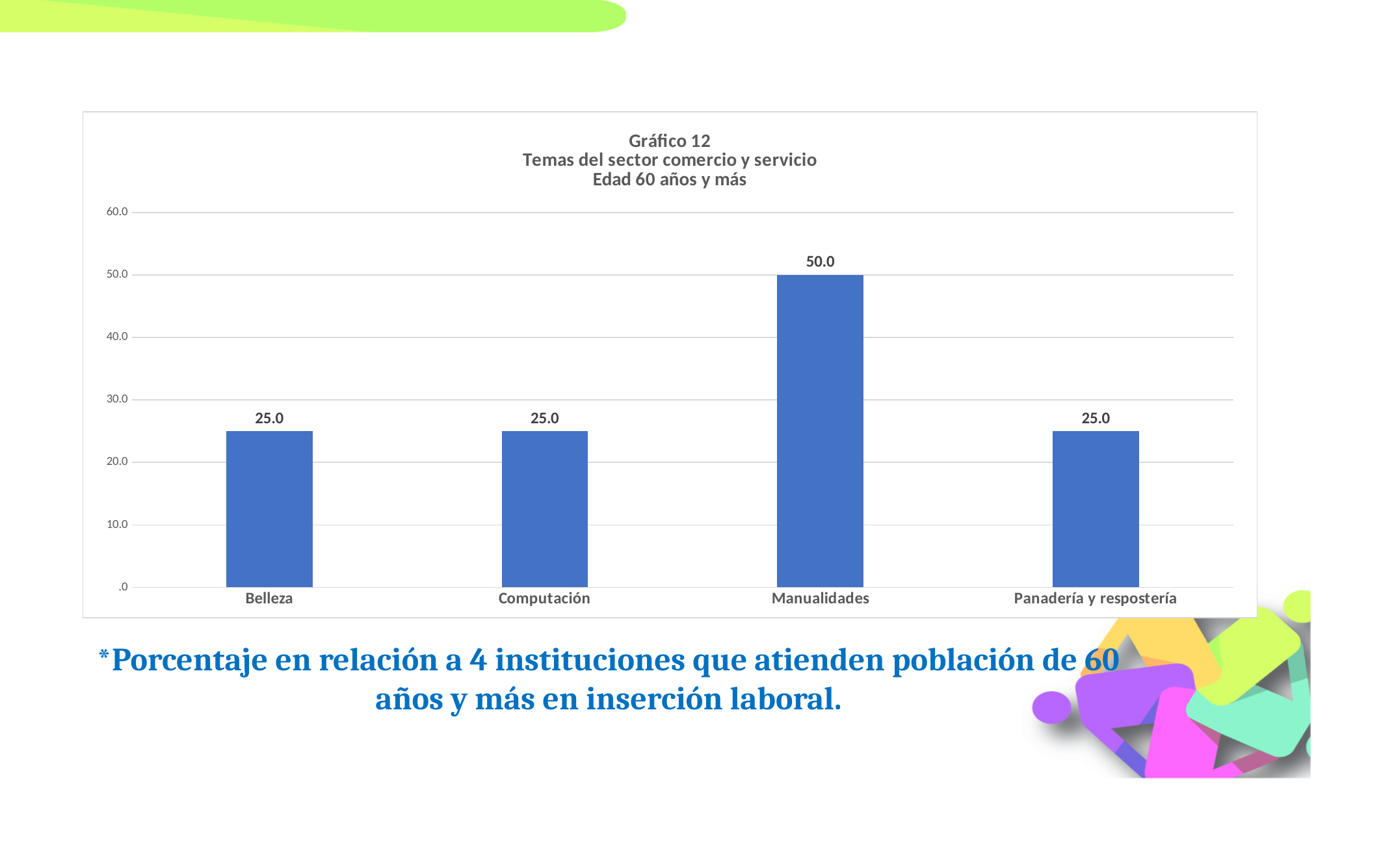
What kind of chart is shown on the slide? bar chart Is the value for Computación greater or less than 30.0? less What is the total of the values for Belleza, Computación, Manualidades and Panadería y respostería? 125.0 Which is larger, the value for Manualidades or the value for Belleza? Manualidades How many categories are shown on the x axis? 4 What is the difference between the values for Manualidades and Computación? 25.0 What is the number of the chart given in its title? Gráfico 12 Is the value for Manualidades greater or less than 40.0? greater Which category has the highest value? Manualidades What is the value for Belleza? 25.0 What is the value for Manualidades? 50.0 What is the value for Panadería y respostería? 25.0